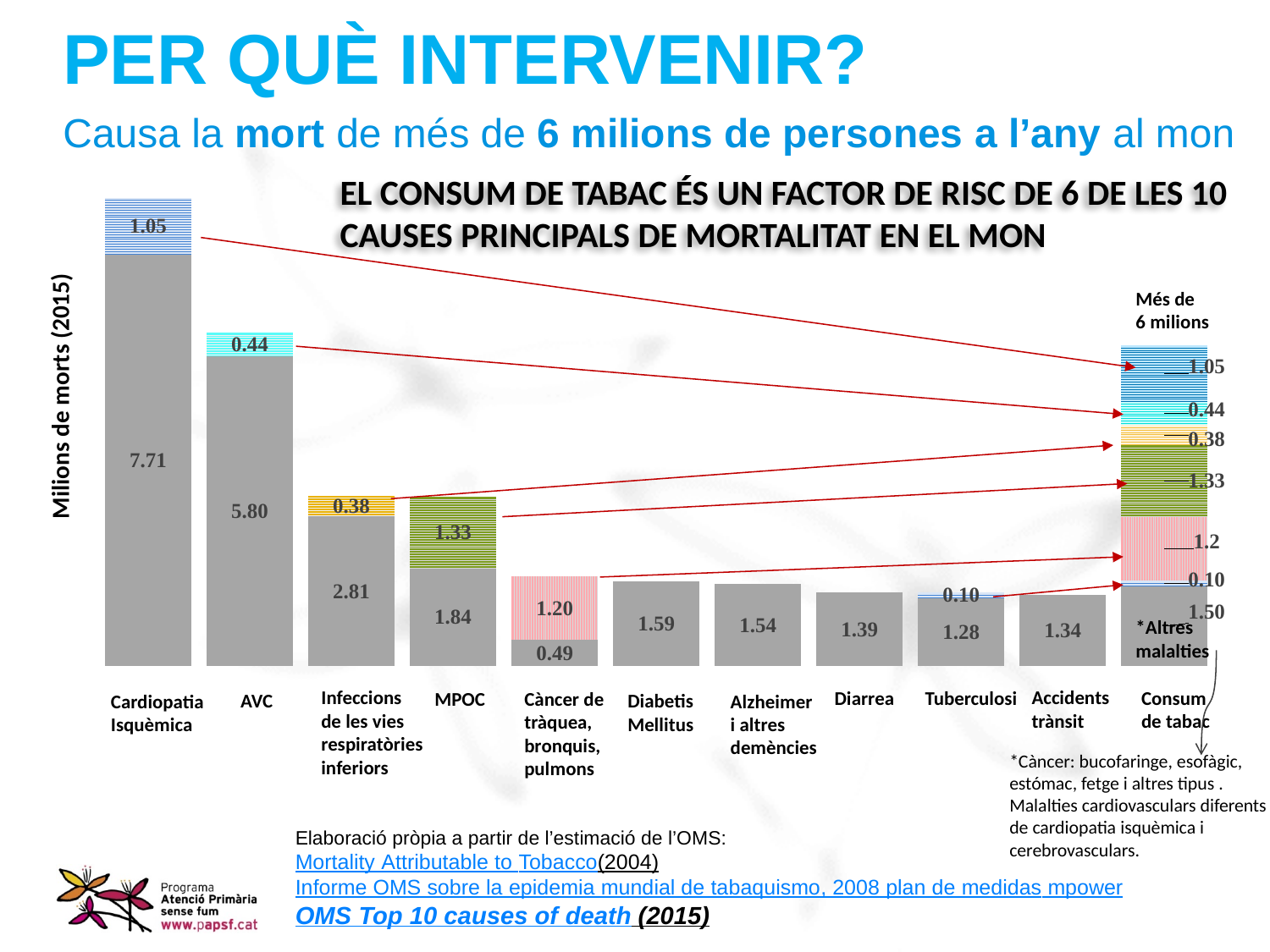
What is the total of the Càncer de tràquea, bronquis, pulmons bar (0.49 + 1.20)? 1.69 Which category has the tallest bar? Cardiopatia Isquèmica What type of chart is shown on the slide? Stacked bar chart What is the value of the green segment on the MPOC bar? 1.33 What is the grey (non-tobacco) value shown for Cardiopatia Isquèmica? 7.71 Which is larger, the value for Diarrea or the value for Accidents trànsit? Diarrea What is the total of the MPOC bar (1.84 + 1.33)? 3.17 What is the value of the bottom segment of the Consum de tabac bar? 1.50 How many categories are shown along the x axis of the chart? 11 What is the difference between the grey values for Cardiopatia Isquèmica (7.71) and AVC (5.80)? 1.91 What value is printed on the top segment of the AVC bar? 0.44 What value is shown for Diabetis Mellitus? 1.59